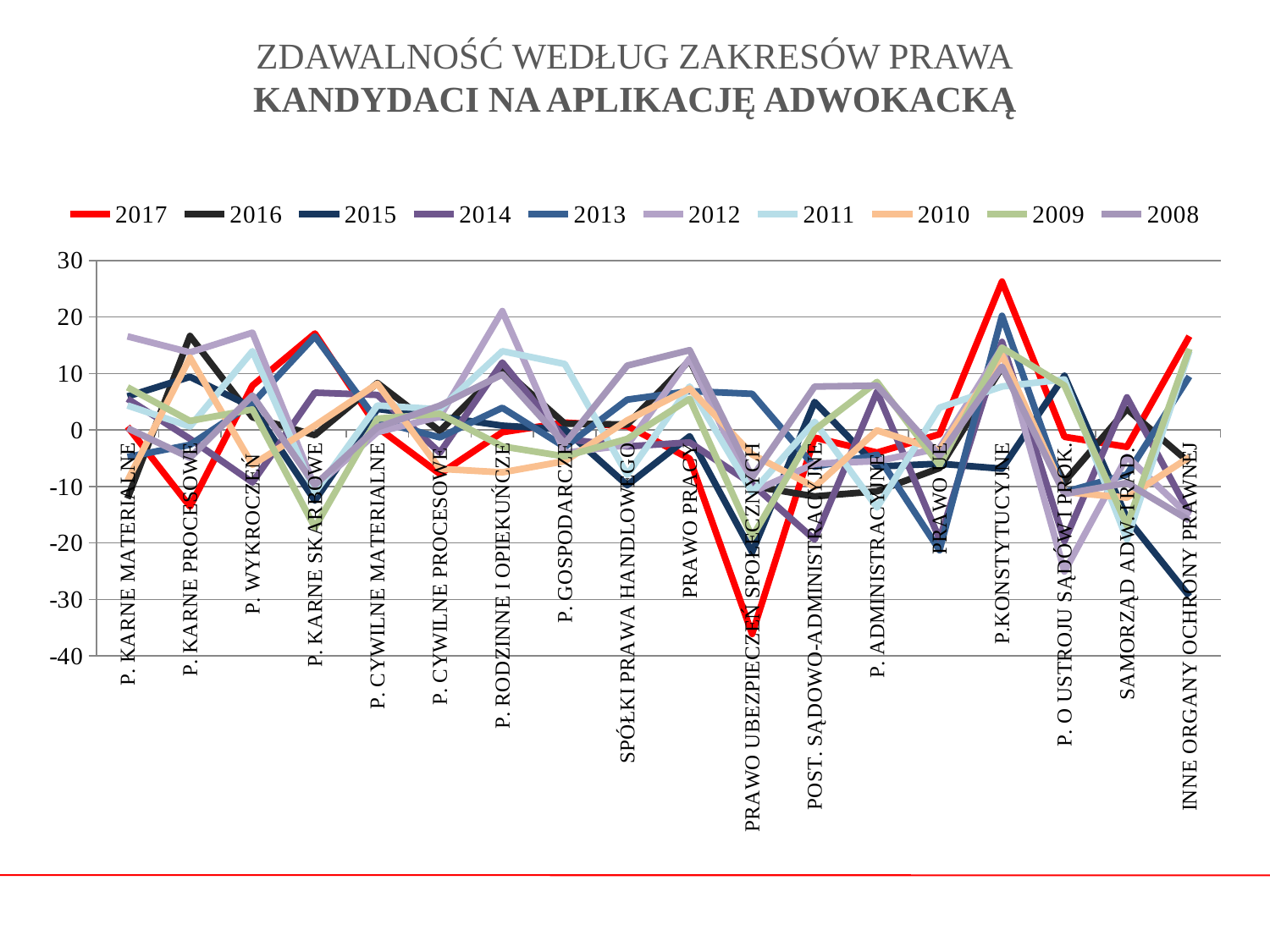
How many series does the legend list? 10 For the 2017 series, which category has the lowest value? PRAWO UBEZPIECZEŃ SPOŁECZNYCH For the 2017 series, which is larger: the value for P. KONSTYTUCYJNE or the value for P. KARNE SKARBOWE? P. KONSTYTUCYJNE What kind of chart is shown on the slide? line chart Is the 2017 value for P. KONSTYTUCYJNE greater or less than 20? greater Which series is drawn in red? 2017 Is the 2017 value for PRAWO UBEZPIECZEŃ SPOŁECZNYCH greater or less than -30? less For the 2017 series, which category has the highest value? P. KONSTYTUCYJNE Is the 2015 value for INNE ORGANY OCHRONY PRAWNEJ greater or less than -20? less How many categories (areas of law) are plotted along the x axis? 18 What is the lowest value shown on the vertical axis? -40